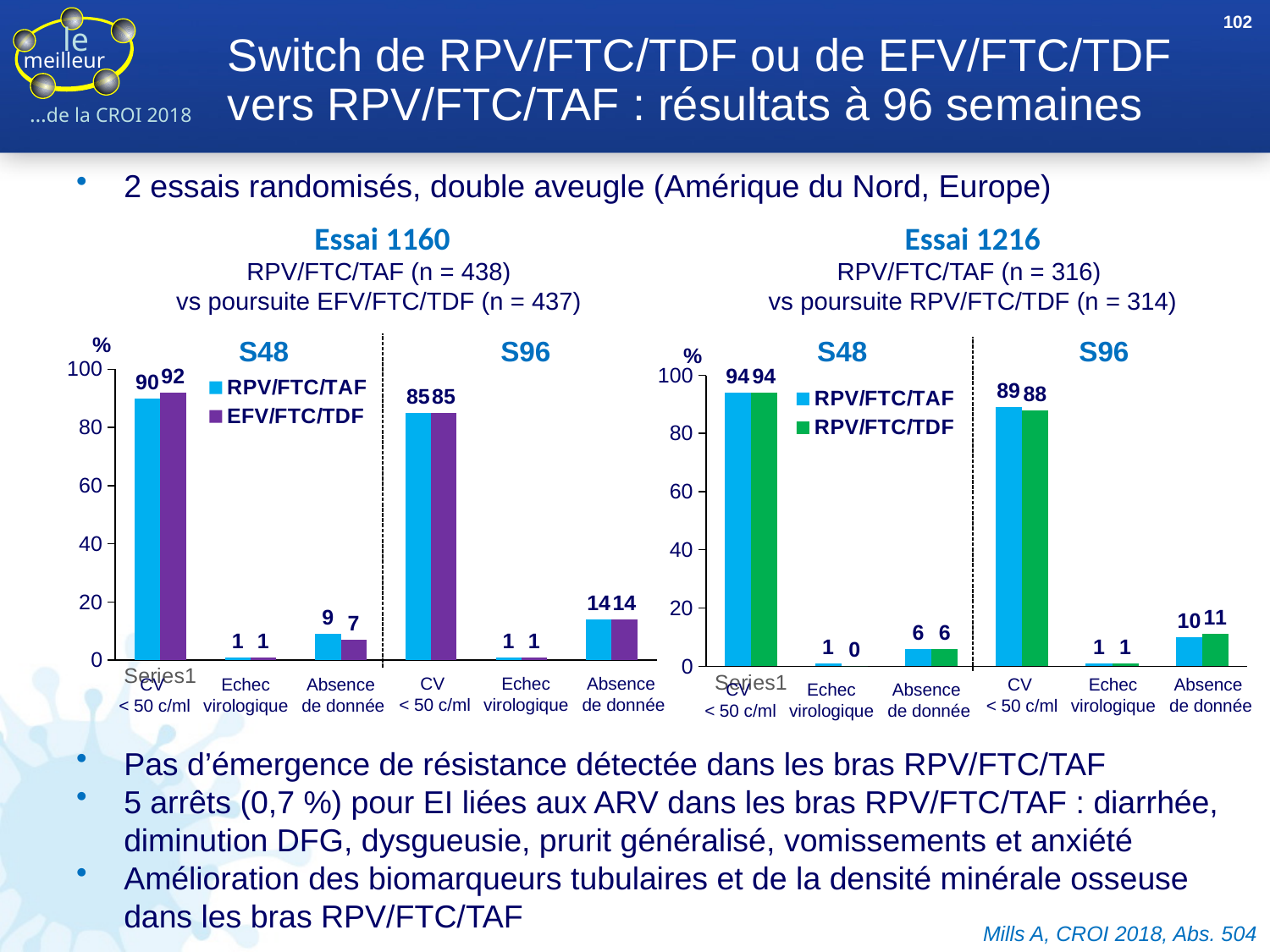
In the Essai 1216 chart, what is the value for RPV/FTC/TDF for Absence de donnée at S96? 11 In the Essai 1160 chart, what is the value for RPV/FTC/TAF for CV < 50 c/ml at S48? 90 In the Essai 1216 chart, what is the value for RPV/FTC/TAF for CV < 50 c/ml at S48? 94 How many series does the legend of the Essai 1216 chart list? 2 In the Essai 1160 chart, what is the value for both arms for Absence de donnée at S96? 14 In the Essai 1160 chart, what is the value for EFV/FTC/TDF for Absence de donnée at S48? 7 In the Essai 1216 chart, what is the value for RPV/FTC/TDF for Echec virologique at S48? 0 In the Essai 1160 chart, is the RPV/FTC/TAF value for CV < 50 c/ml at S96 greater or less than 80? greater In the Essai 1160 chart, what is the difference between the EFV/FTC/TDF and RPV/FTC/TAF values for CV < 50 c/ml at S48? 2 What kind of chart is the Essai 1160 chart? Bar chart In the Essai 1216 chart, which series is shown in green? RPV/FTC/TDF In the Essai 1216 chart, which arm has the higher value for CV < 50 c/ml at S96, RPV/FTC/TAF or RPV/FTC/TDF? RPV/FTC/TAF